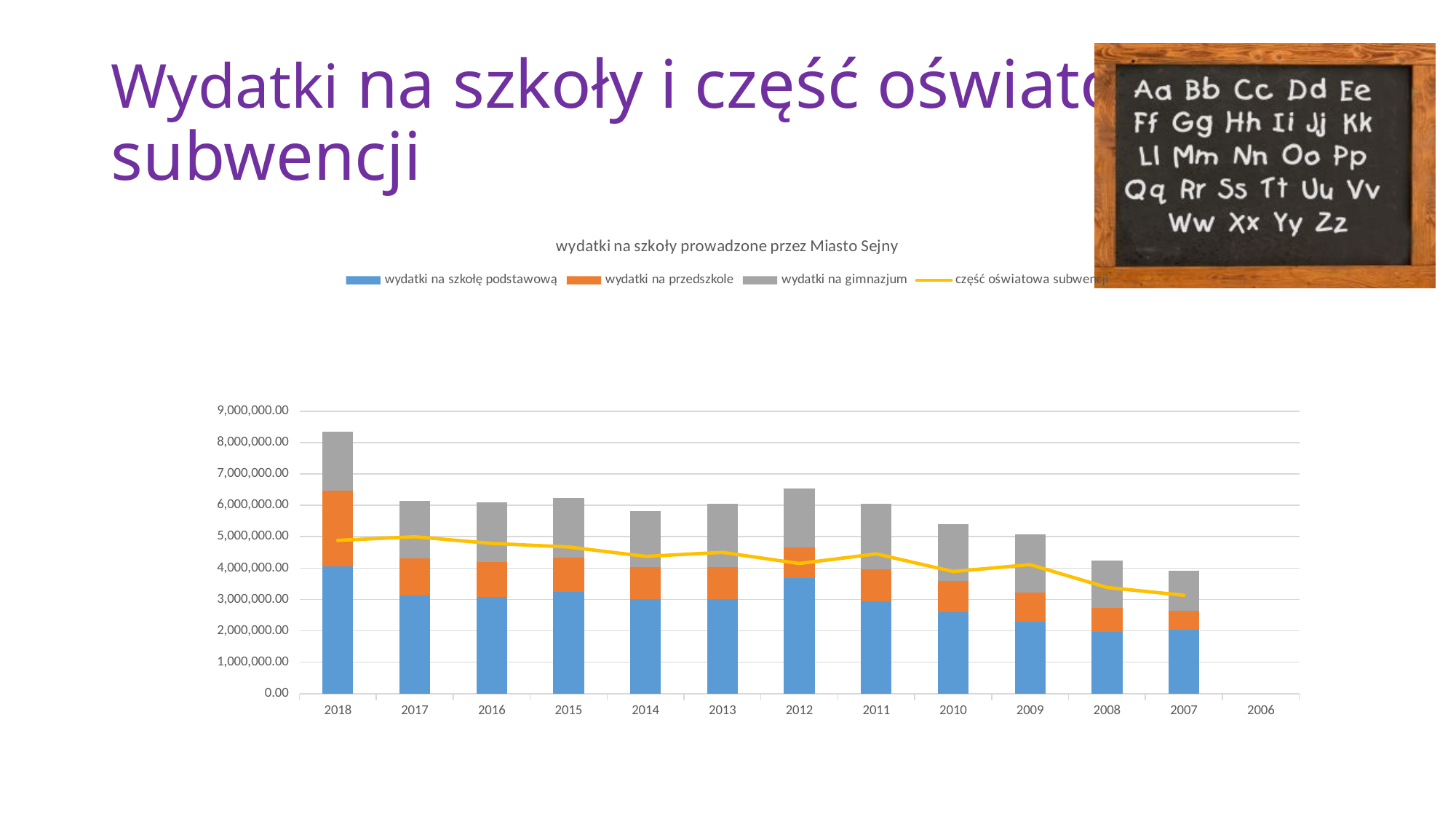
What is the title of the chart? wydatki na szkoły prowadzone przez Miasto Sejny Does the część oświatowa subwencji line rise or fall overall from 2018 to 2007 along the x axis? fall Is the value of the część oświatowa subwencji line for 2007 greater or less than 4,000,000.00? less Which year with a bar has the shortest stacked bar? 2007 Which year has the larger total stacked bar, 2012 or 2011? 2012 How many series does the chart legend list? 4 How many stacked bars are plotted in the chart? 12 Which colour represents wydatki na gimnazjum in the legend? grey What kind of chart is shown on the slide? stacked bar chart with a line Which year has the tallest stacked bar? 2018 Is the total stacked bar for 2008 greater or less than 5,000,000.00? less Is the total stacked bar for 2018 greater or less than 8,000,000.00? greater